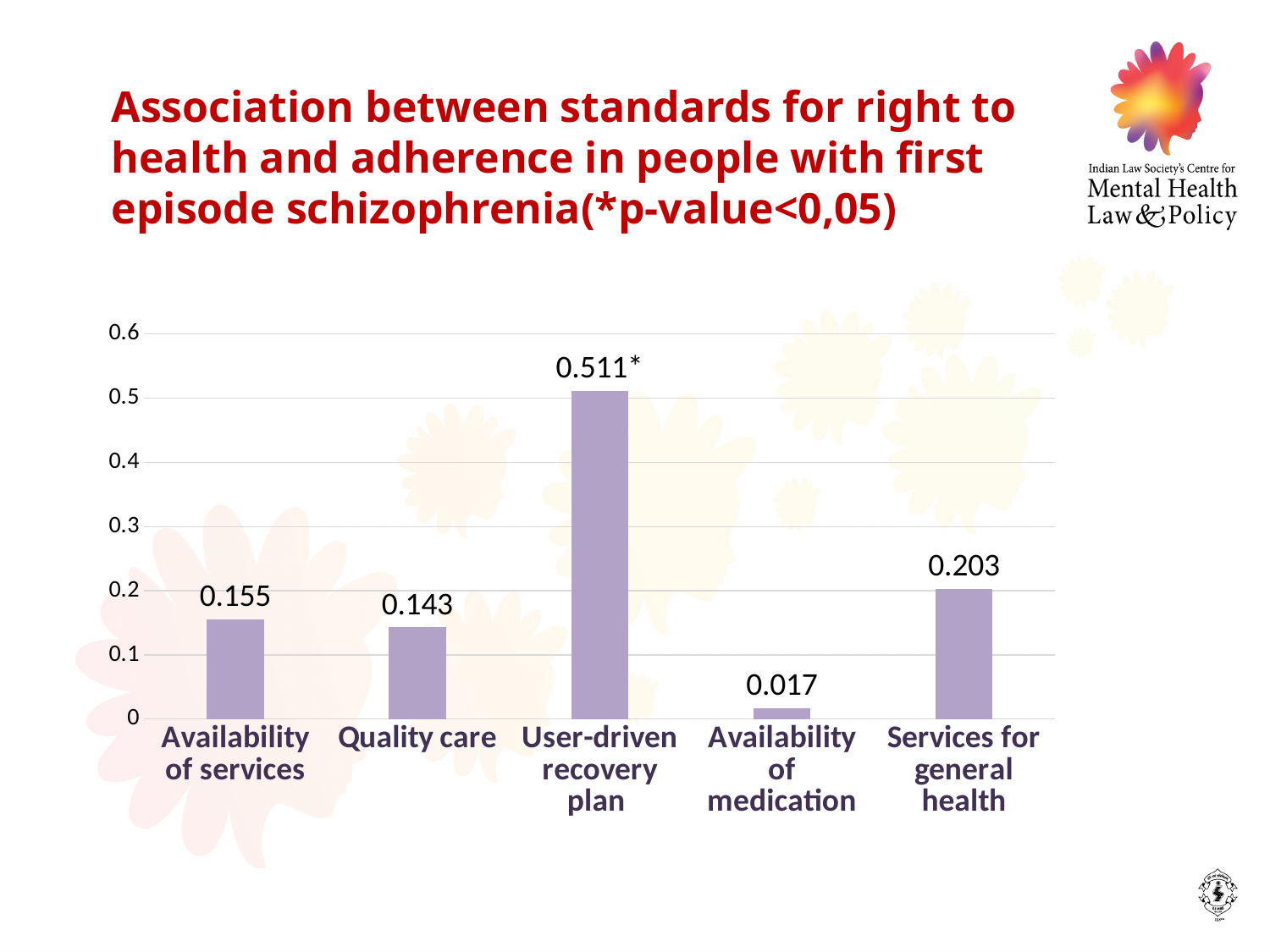
What kind of chart is shown on the slide? Bar chart Which category has the highest value? User-driven recovery plan What is the difference between the values for User-driven recovery plan and Services for general health? 0.308 Which category's value is marked with an asterisk indicating p-value<0,05? User-driven recovery plan What is the value for Quality care? 0.143 What is the value for Availability of medication? 0.017 What is the value for User-driven recovery plan? 0.511 How many categories are shown on the chart? 5 What is the value for Services for general health? 0.203 Which category has the lowest value? Availability of medication Which is larger, the value for Services for general health or the value for Availability of services? Services for general health What is the value for Availability of services? 0.155